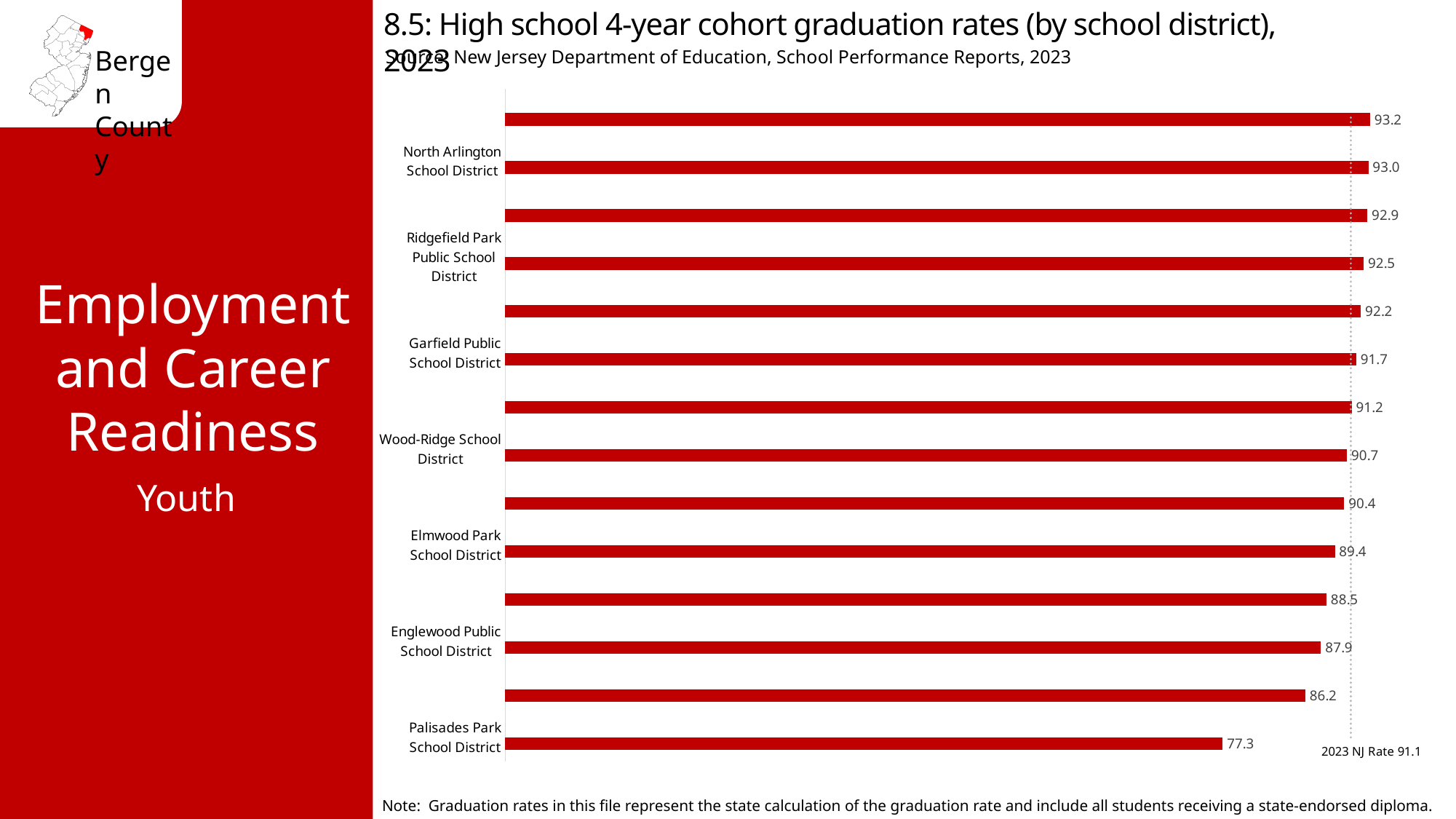
What is the graduation rate for Wood-Ridge School District? 90.7 How many bars are plotted in the chart? 14 What is the graduation rate for Ridgefield Park Public School District? 92.5 What kind of chart is shown on the slide? Bar chart Which has a higher graduation rate, Elmwood Park School District or Englewood Public School District? Elmwood Park School District Which labeled school district has the lowest graduation rate? Palisades Park School District What is the graduation rate for Palisades Park School District? 77.3 What is the difference between the graduation rates of North Arlington School District and Palisades Park School District? 15.7 Do the graduation rates increase or decrease going from the top bar to the bottom bar? Decrease What is the 2023 NJ rate shown as a reference line on the chart? 91.1 What is the graduation rate for North Arlington School District? 93.0 What is the graduation rate for Garfield Public School District? 91.7